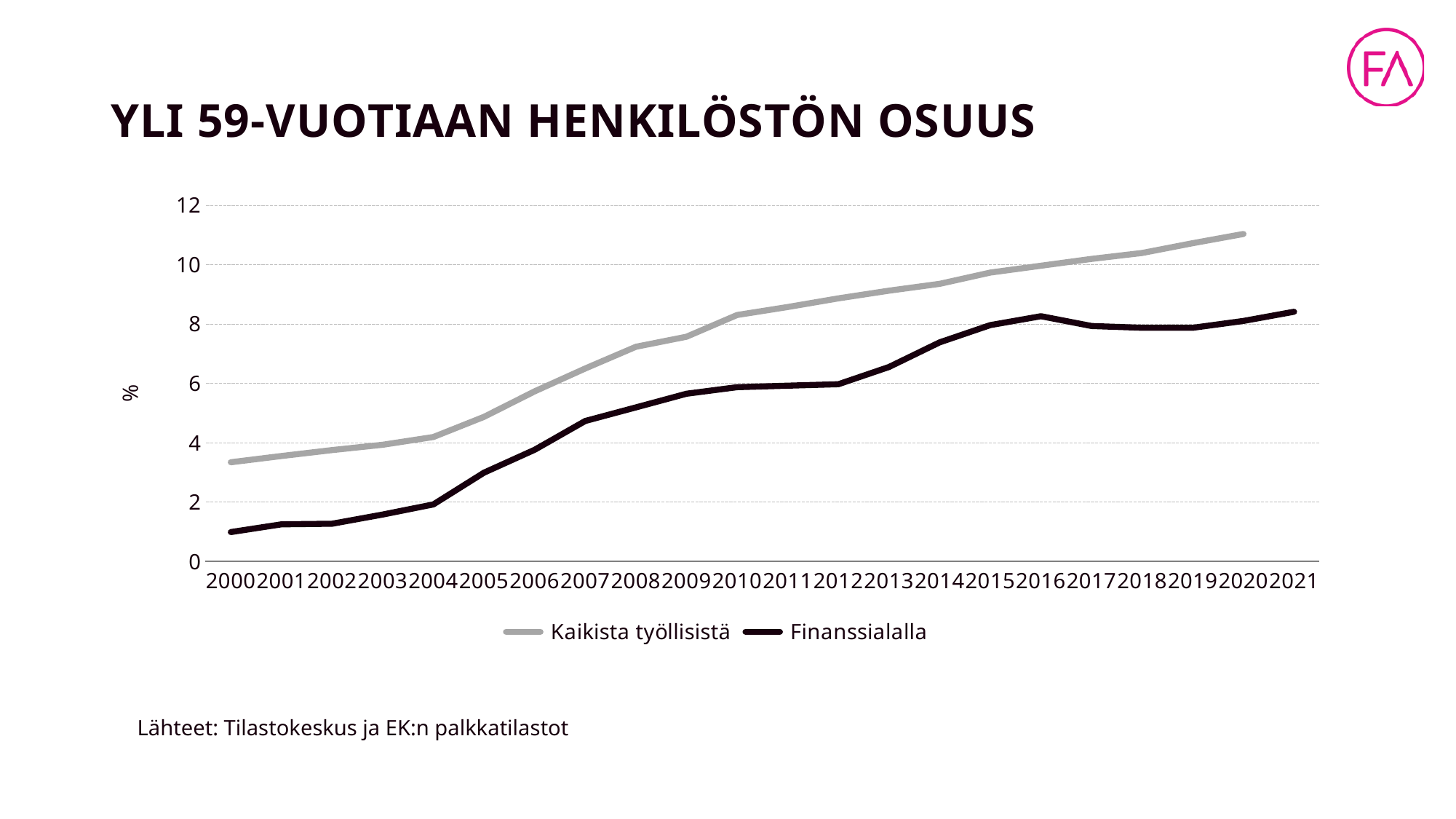
What kind of chart is shown on the slide? line chart Is the Kaikista työllisistä value for 2020 greater or less than 10? greater Does the Kaikista työllisistä line rise or fall from 2000 to 2020? rise Is the Finanssialalla value for 2000 greater or less than 2? less In which year is the Kaikista työllisistä value highest? 2020 Is the Finanssialalla value for 2008 greater or less than 4? greater How many years are shown on the x axis? 22 In which year is the Finanssialalla value lowest? 2000 Which series is drawn in grey? Kaikista työllisistä How many series does the legend list? 2 What is the title of the chart? YLI 59-VUOTIAAN HENKILÖSTÖN OSUUS In 2010, which series has the higher value, Kaikista työllisistä or Finanssialalla? Kaikista työllisistä